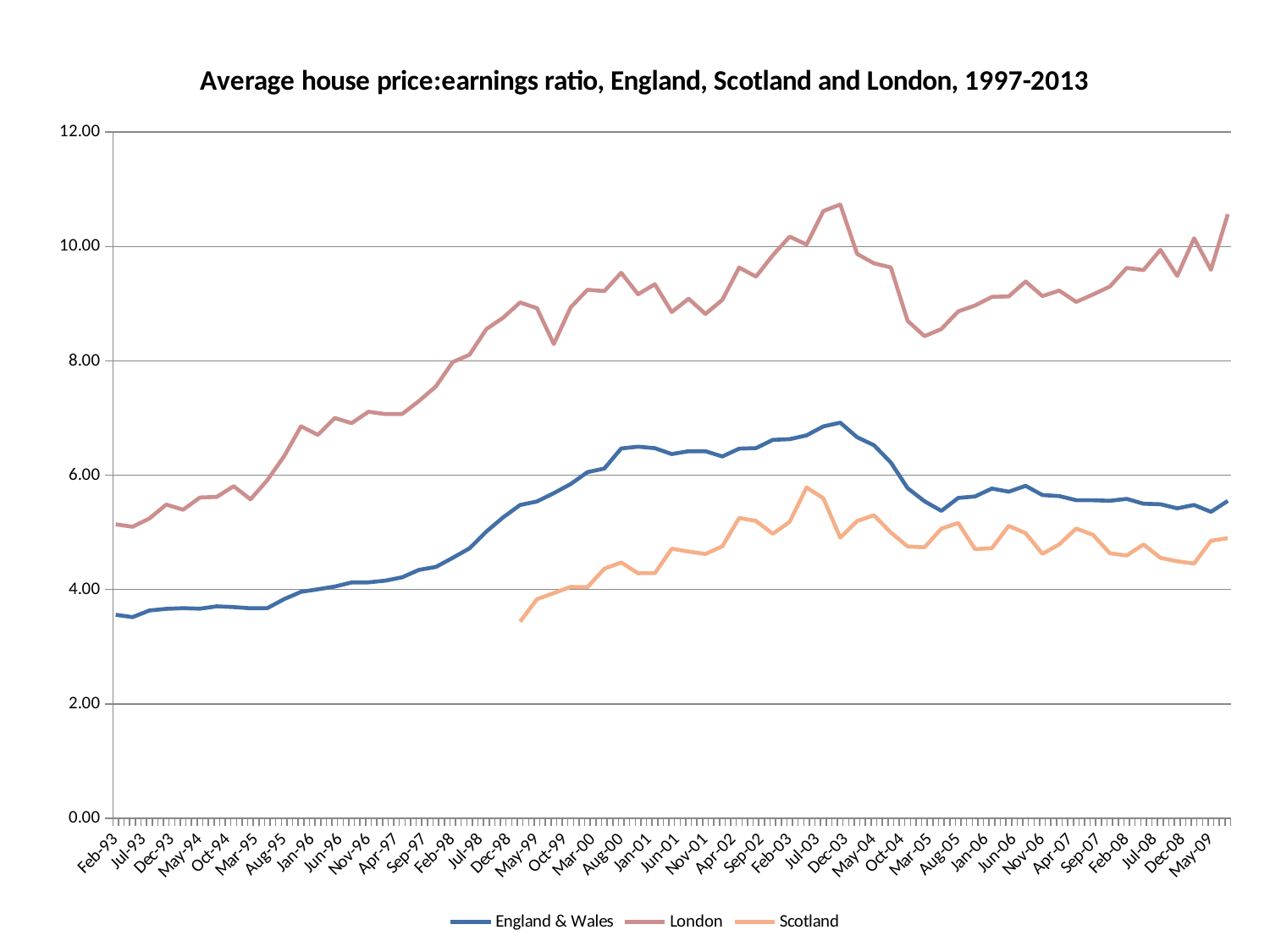
How many series does the legend list? 3 Is the value for England & Wales at Dec-03 greater or less than 6.00? greater Do the values for England & Wales rise or fall from Feb-93 to Dec-03? rise What is the title of the chart? Average house price:earnings ratio, England, Scotland and London, 1997-2013 Is the value for London at Dec-98 greater or less than 8.00? greater Is the value for England & Wales at Feb-93 greater or less than 4.00? less At Jul-03, which is larger: the value for London or the value for England & Wales? London What kind of chart is shown on the slide? Line chart Do the values for London rise or fall from Dec-03 to Mar-05? fall Which series has the highest values throughout the chart? London